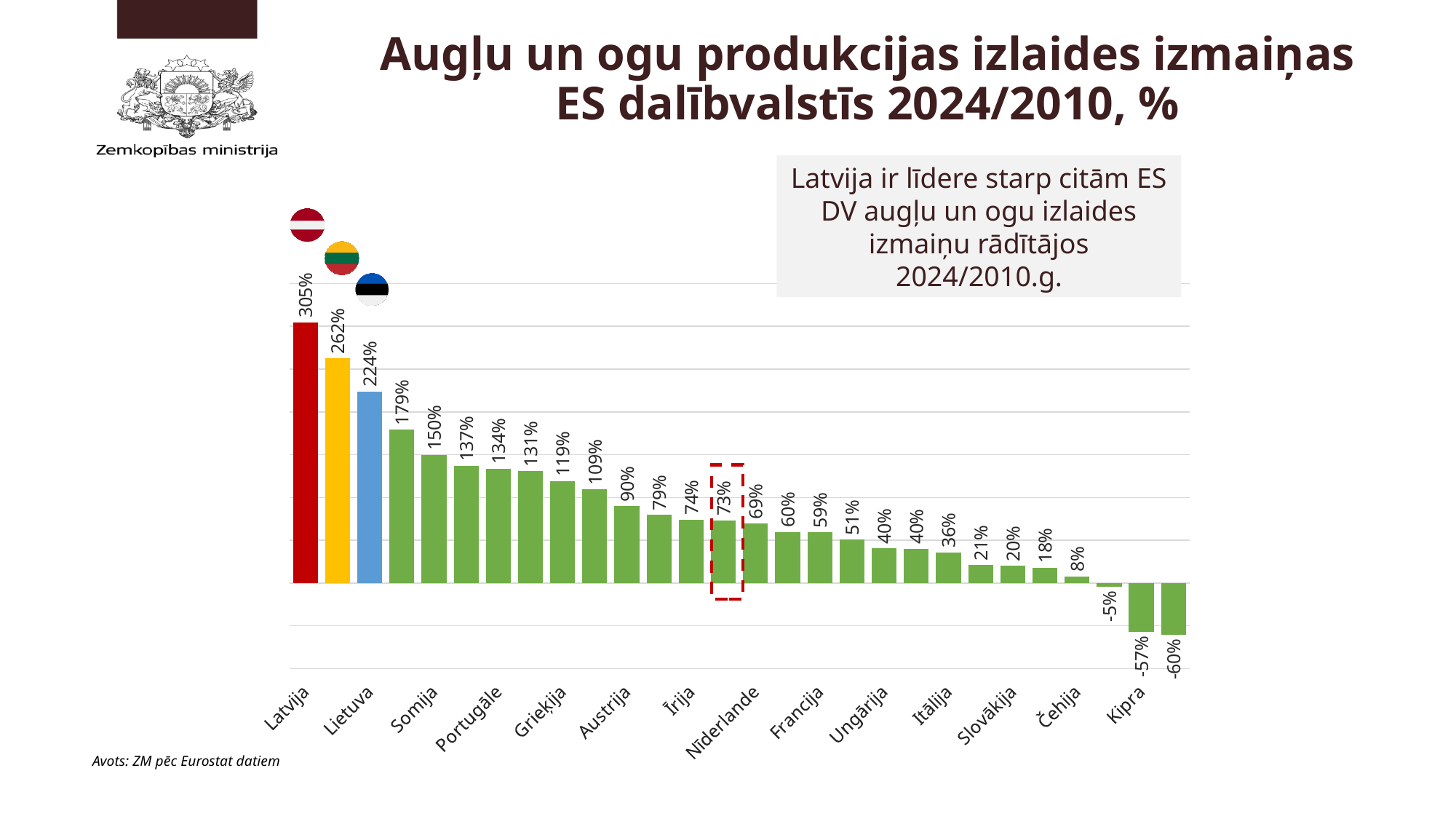
What is the title of the chart on the slide? Augļu un ogu produkcijas izlaides izmaiņas ES dalībvalstīs 2024/2010, % What is the lowest value shown in the chart? -60% Which country has the highest value in the chart? Latvija Which value is highlighted with a red dashed box in the chart? 73% Is the value for Latvija greater or less than 300%? greater What is the value shown for Latvija? 305% How many bars are plotted in the chart? 28 What is the difference between the highest value (305%) and the second highest value (262%)? 43 percentage points What kind of chart is shown on the slide? Bar chart How many bars in the chart have negative values? 3 Do the values rise or fall from left to right along the x axis? Fall What is the value of the second highest bar in the chart? 262%